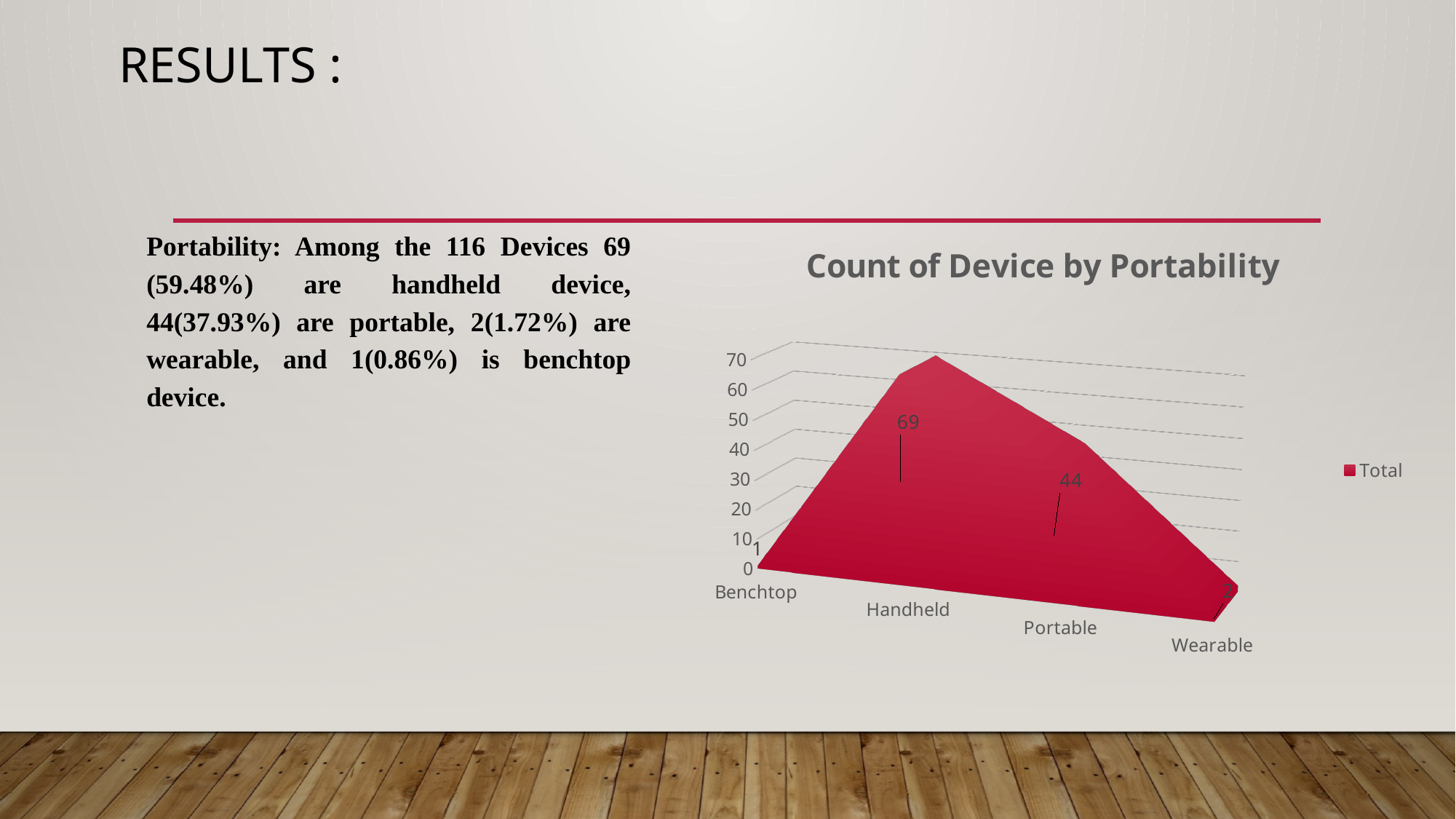
What is the value for Portable in the chart? 44 What is the value for Handheld in the chart? 69 What is the title of the chart? Count of Device by Portability What is the value for Benchtop in the chart? 1 Which is larger, the value for Portable or the value for Wearable? Portable How many categories are shown on the x axis of the chart? 4 How many series does the chart legend list? 1 Which category has the highest value in the chart? Handheld Is the value for Handheld greater or less than 60? greater What is the difference between the values for Handheld and Portable? 25 Which category has the lowest value in the chart? Benchtop What is the value for Wearable in the chart? 2